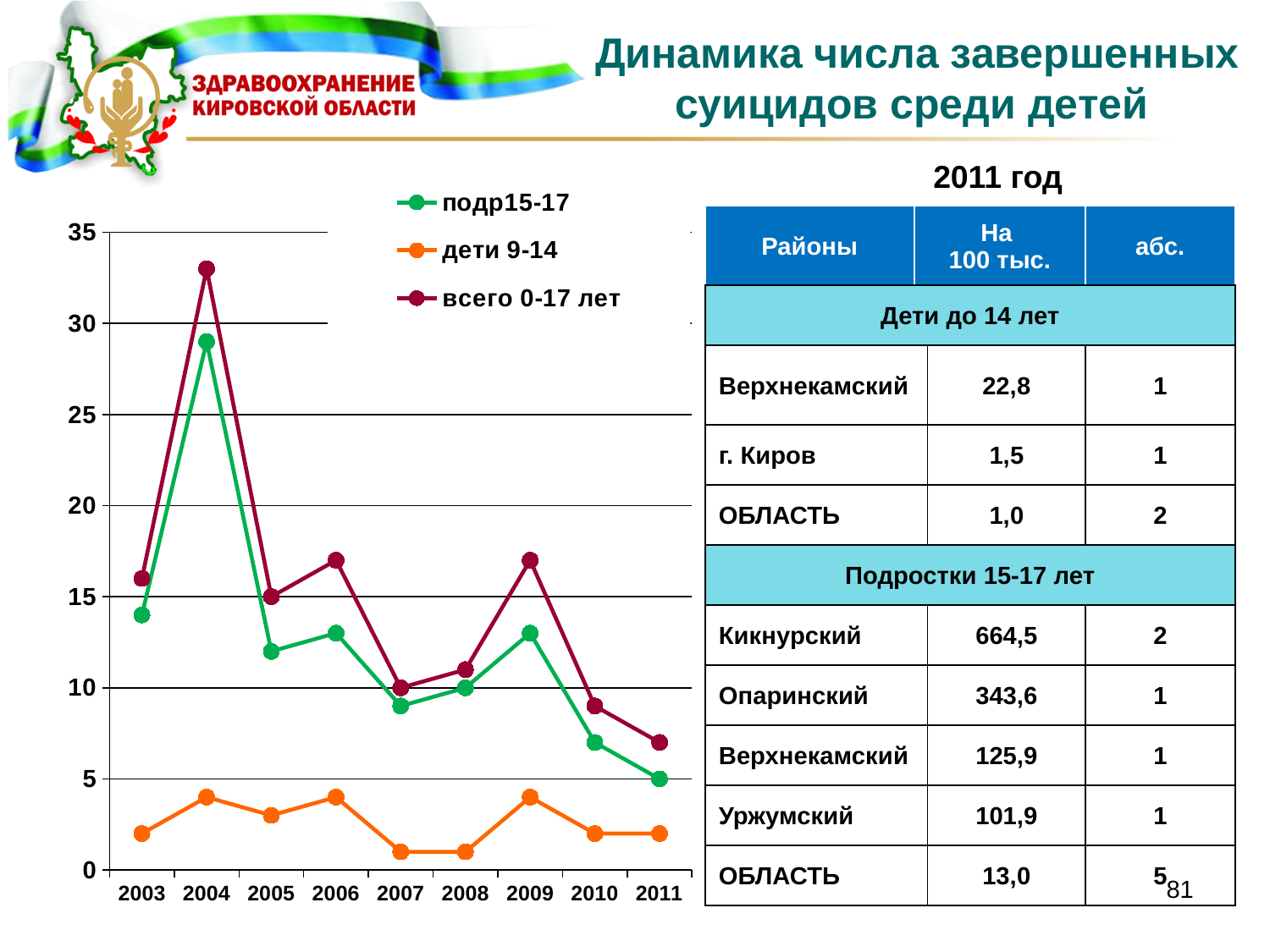
Is the value for 'всего 0-17 лет' in 2004 greater or less than 30? greater Is the value for 'подр15-17' in 2004 greater or less than 25? greater In 2003, which series has the larger value: 'подр15-17' or 'дети 9-14'? подр15-17 Is the value for 'подр15-17' in 2007 greater or less than 10? less Does the series 'всего 0-17 лет' rise or fall from 2009 to 2011? fall How many years are plotted along the x axis of the chart? 9 What are the three series names listed in the chart legend? подр15-17, дети 9-14, всего 0-17 лет In which year does the series 'всего 0-17 лет' reach its highest value? 2004 How many series does the chart legend list? 3 In which year does the series 'всего 0-17 лет' reach its lowest value? 2011 What kind of chart is shown on the slide? line chart